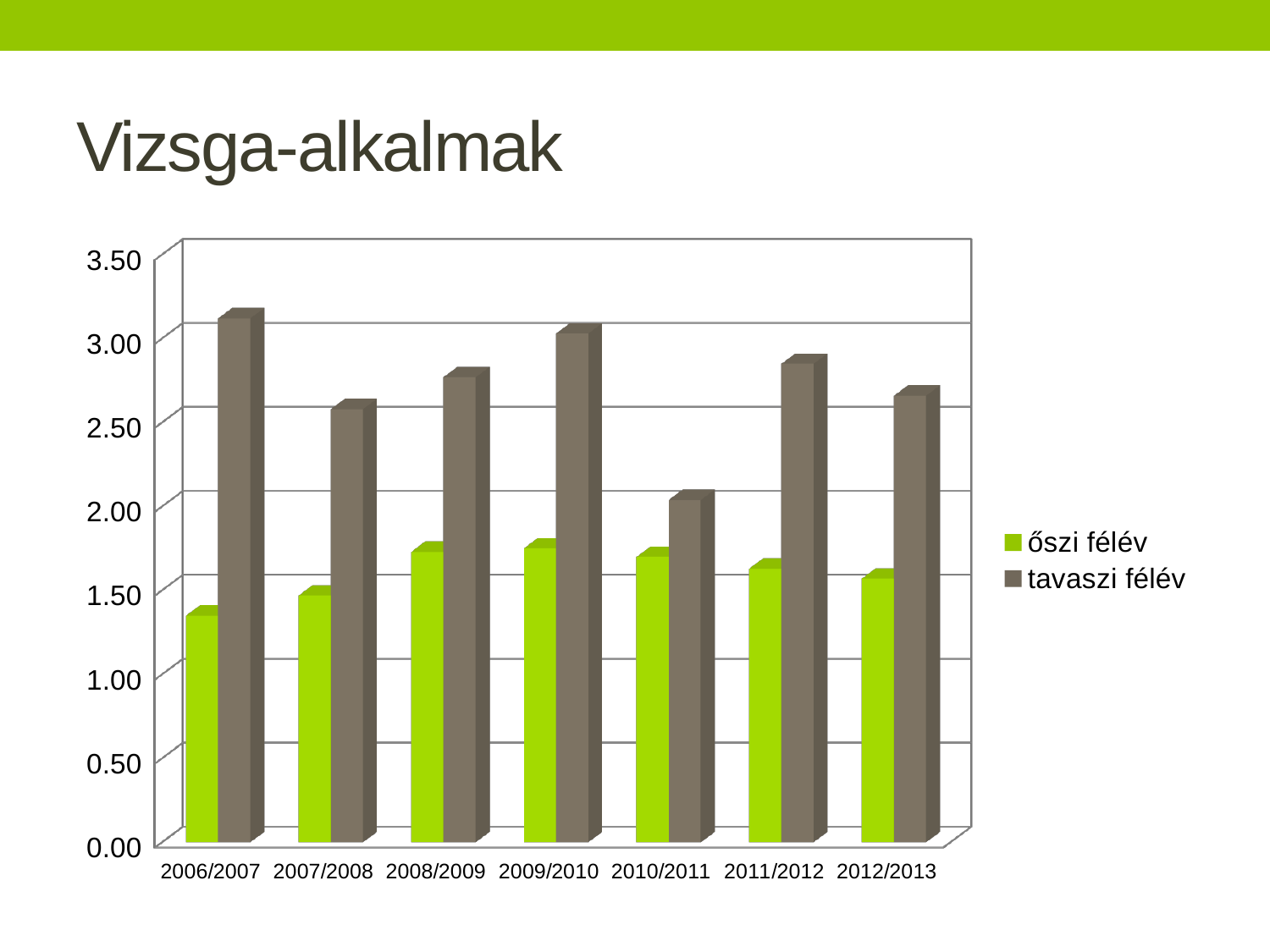
Is the őszi félév value for 2006/2007 greater or less than 1.50? less For 2010/2011, which series has the larger value, őszi félév or tavaszi félév? tavaszi félév Is the tavaszi félév value for 2006/2007 greater or less than 3.00? greater How many academic years are shown on the x axis? 7 In which year is the tavaszi félév value lowest? 2010/2011 What is the title of the chart? Vizsga-alkalmak Which series is shown in green? őszi félév Is the tavaszi félév value for 2011/2012 greater or less than 2.50? greater How many series does the legend list? 2 In which year is the őszi félév value lowest? 2006/2007 What kind of chart is shown on the slide? bar chart